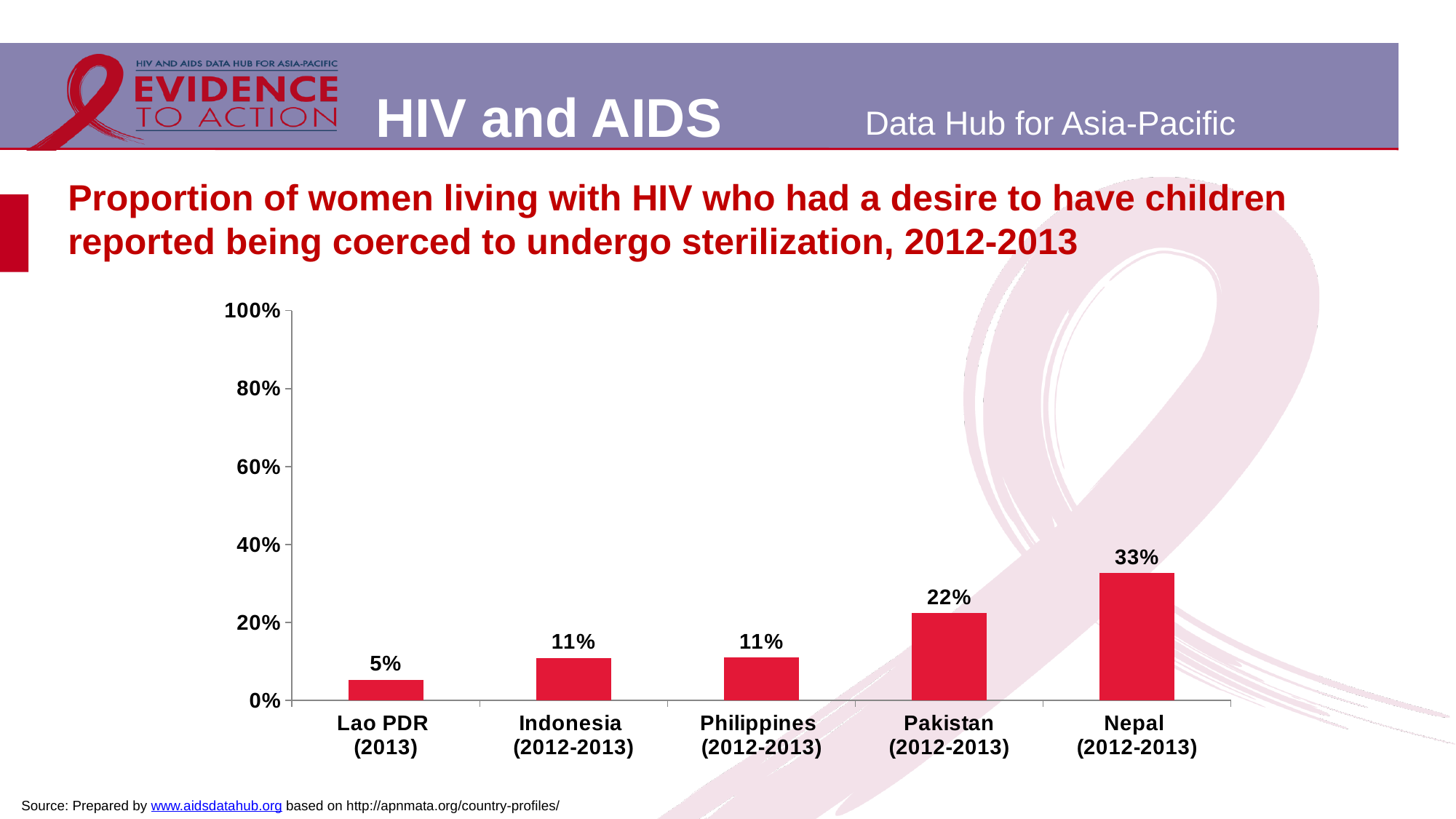
Is the value for Nepal greater or less than 40%? less Which country has the lowest proportion? Lao PDR (2013) What is the difference between the values for Nepal and Pakistan? 11% What is the value for Lao PDR (2013)? 5% Which country has the highest proportion? Nepal (2012-2013) How many countries are shown on the chart? 5 What is the value for Nepal (2012-2013)? 33% What is the difference between the values for Indonesia and Lao PDR? 6% Which is larger, the value for Pakistan or the value for Philippines? Pakistan What is the maximum value shown on the vertical axis? 100% What is the value for Pakistan (2012-2013)? 22% What kind of chart is shown on the slide? bar chart